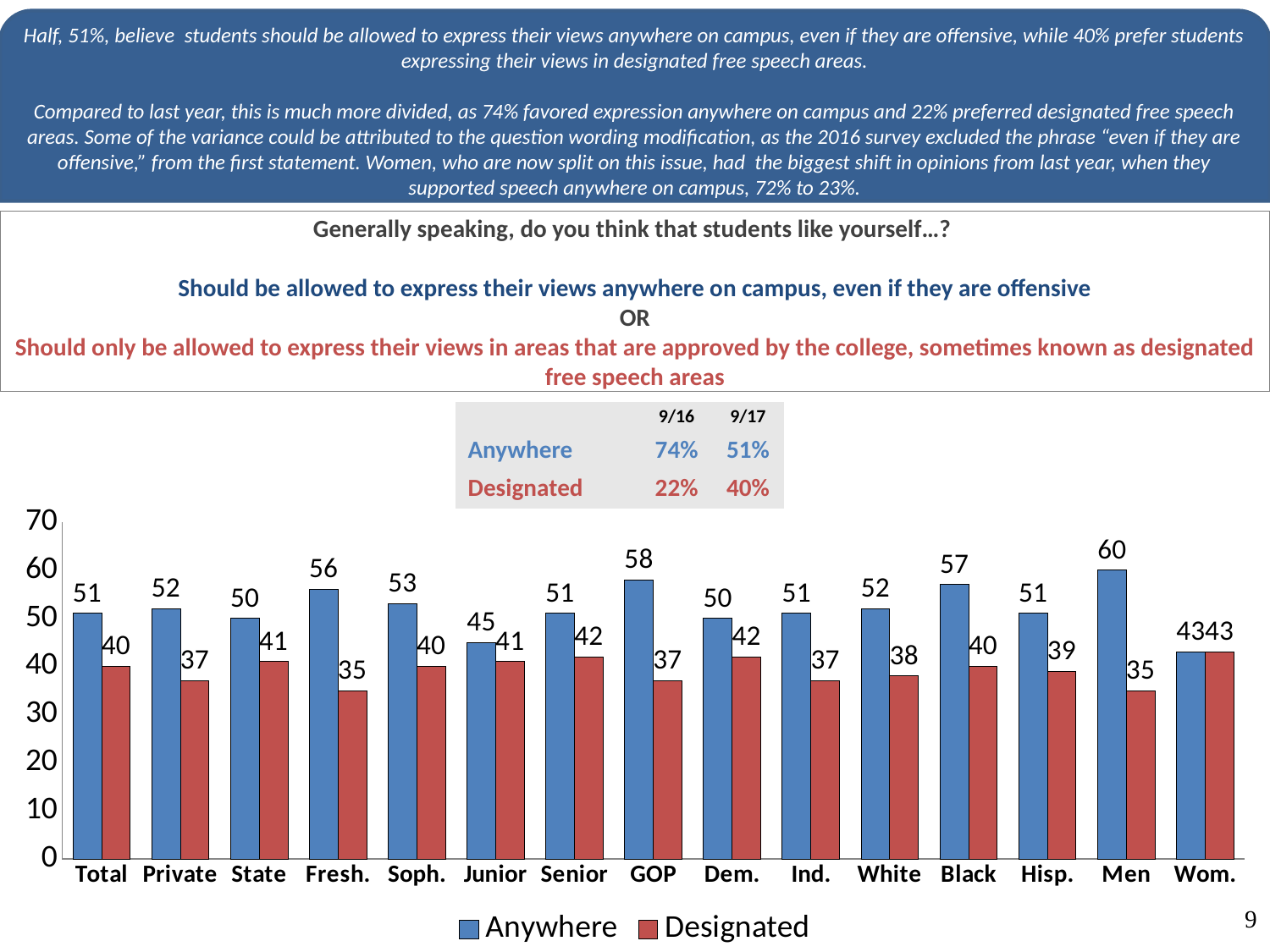
Which is larger for Fresh., the Anywhere value or the Designated value? Anywhere How many categories are shown on the x axis of the chart? 15 What kind of chart is shown on the slide? bar chart What is the Anywhere value for Junior? 45 Which category has the lowest Anywhere value? Wom. Is the Anywhere value for Black greater or less than 50? greater What is the Designated value for Senior? 42 Which category has the highest Designated value? Wom. How many series does the chart legend list? 2 What is the difference between the Anywhere and Designated values for GOP? 21 Which category has the highest Anywhere value? Men What is the Anywhere value for Men? 60